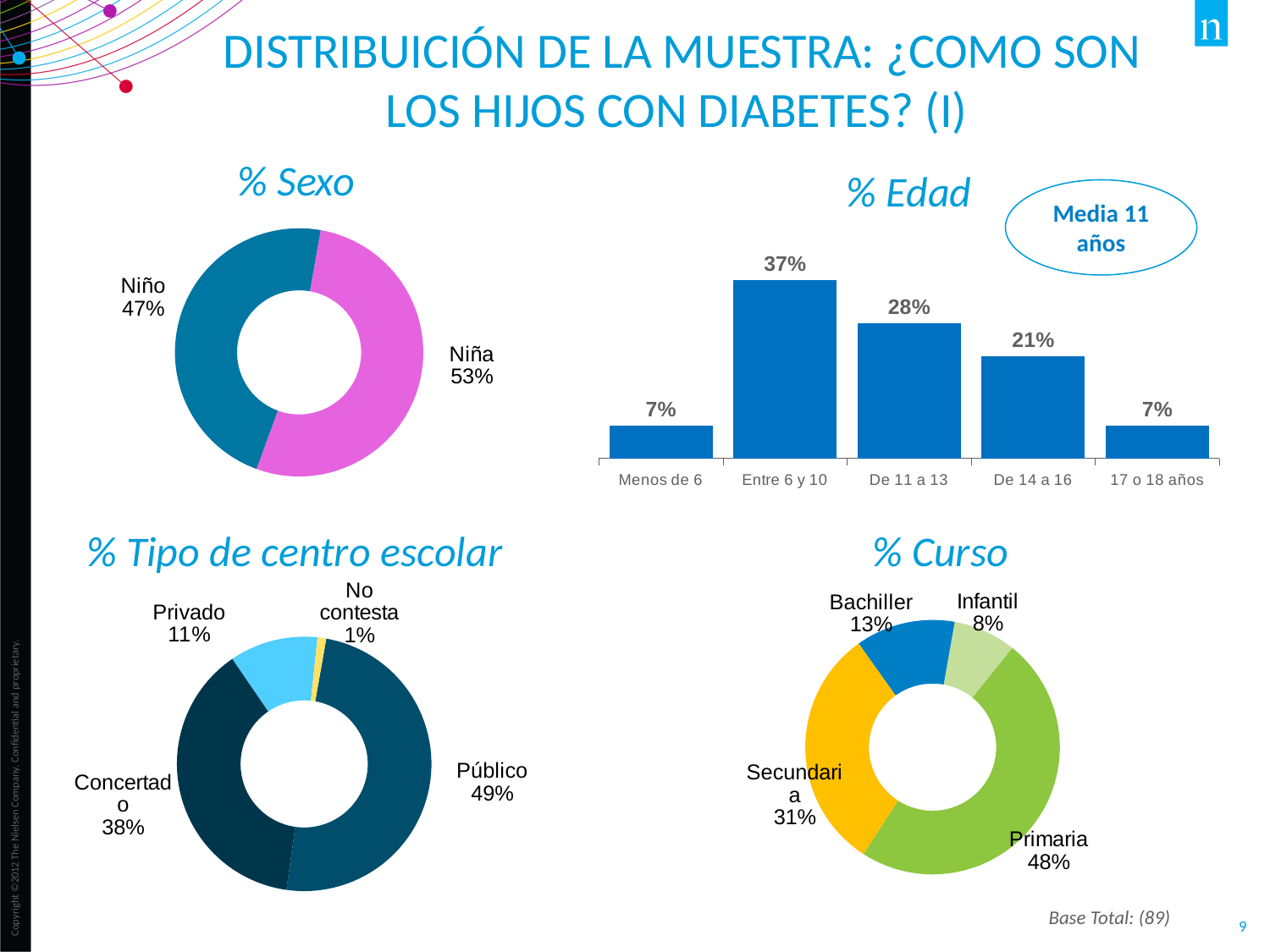
In the '% Tipo de centro escolar' chart, which is larger, Concertado or Privado? Concertado What average age is shown in the oval next to the '% Edad' chart? Media 11 años In the '% Edad' chart, how many age categories are shown on the x axis? 5 In the '% Edad' chart, which age group has the highest value? Entre 6 y 10 In the '% Sexo' chart, what percentage is Niña? 53% In the '% Edad' chart, what is the difference between 'De 11 a 13' and 'De 14 a 16'? 7% In the '% Curso' chart, what is the difference between Primaria and Bachiller? 35% In the '% Tipo de centro escolar' chart, which category has the lowest share? No contesta What kind of chart is the '% Edad' chart? Bar chart In the '% Tipo de centro escolar' chart, what percentage is Público? 49% In the '% Curso' chart, what percentage is Secundaria? 31% In the '% Edad' chart, what is the value for 'Entre 6 y 10'? 37%